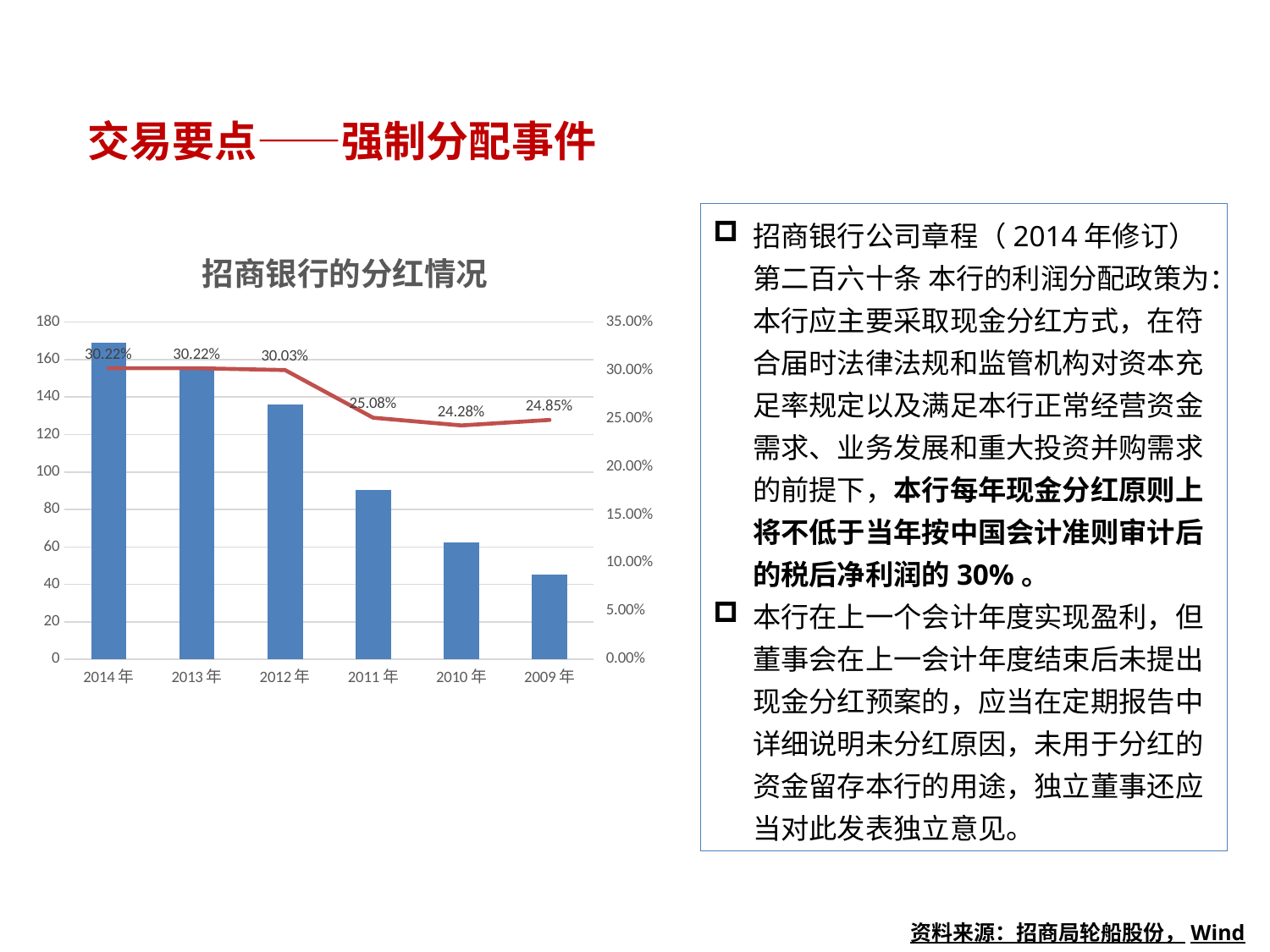
Is the bar value for 2014年 greater or less than 160? greater What is the difference between the percentage values for 2012年 and 2011年? 4.95% Which year has the tallest bar in the chart? 2014年 What is the percentage value shown for 2011年 on the line in the chart? 25.08% What is the percentage value shown for 2010年 on the line in the chart? 24.28% How many years are shown on the x axis of the chart? 6 What is the percentage value shown for 2009年 on the line in the chart? 24.85% Is the bar value for 2011年 greater or less than 100? less What is the percentage value shown for 2014年 on the line in the chart? 30.22% Do the bar values rise or fall moving from 2014年 to 2009年 along the x axis? fall Which year has the lowest percentage value on the line? 2010年 Which has the larger percentage value on the line, 2009年 or 2010年? 2009年